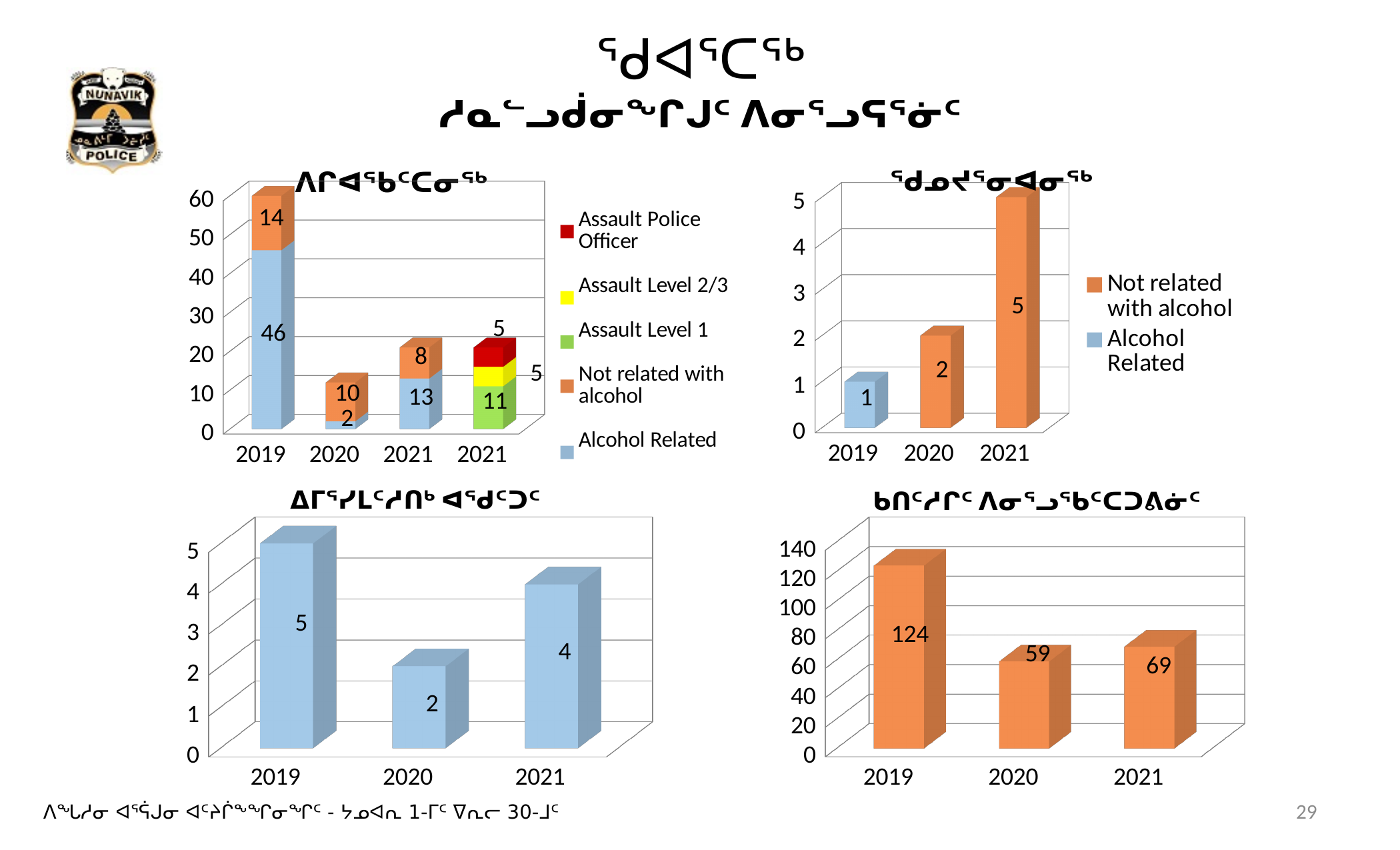
In the bottom-right chart, is the value for 2021 larger or smaller than the value for 2020? larger In the top-left chart, what is the difference between the Alcohol Related values for 2019 and 2021 (first 2021 bar)? 33 How many series does the legend of the top-right chart list? 2 In the bottom-left chart, which year has the highest value? 2019 In the top-left chart, what is the Not related with alcohol value for 2020? 10 In the top-left chart, what is the Alcohol Related value for 2019? 46 In the top-right chart, what is the Not related with alcohol value for 2021? 5 In the bottom-left chart, what is the value for 2020? 2 How many series does the legend of the top-left chart list? 5 In the top-right chart, which year has the lowest bar? 2019 In the top-left chart, what is the total of the stacked bar for 2019? 60 In the bottom-right chart, what is the difference between the values for 2019 and 2020? 65